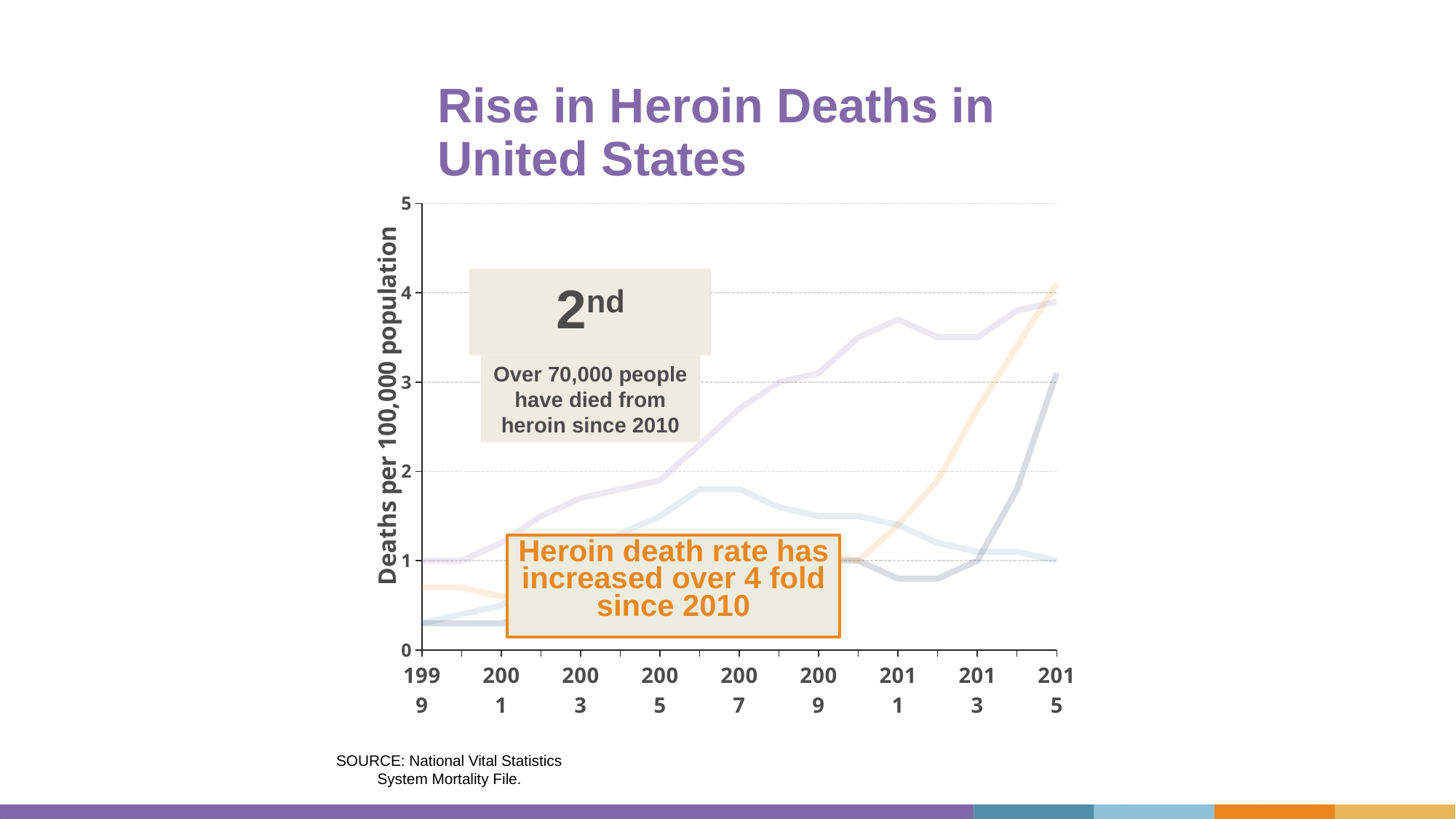
Does the orange line rise or fall overall from 1999 to 2015? rise What is the title of the chart on the slide? Rise in Heroin Deaths in United States Is the value of the light blue line in 2015 greater or less than 2? less Is the value of the orange line in 2015 greater or less than 3? greater What kind of chart is shown on the slide? line chart Is the value of the gray line in 2015 greater or less than 2? greater In 2011, which line has the larger value, the purple line or the orange line? the purple line How many year labels are shown along the x axis of the chart? 9 Which line has the lowest value in 2015? the light blue line What is the label on the vertical axis of the chart? Deaths per 100,000 population Does the purple line rise or fall overall from 1999 to 2015? rise